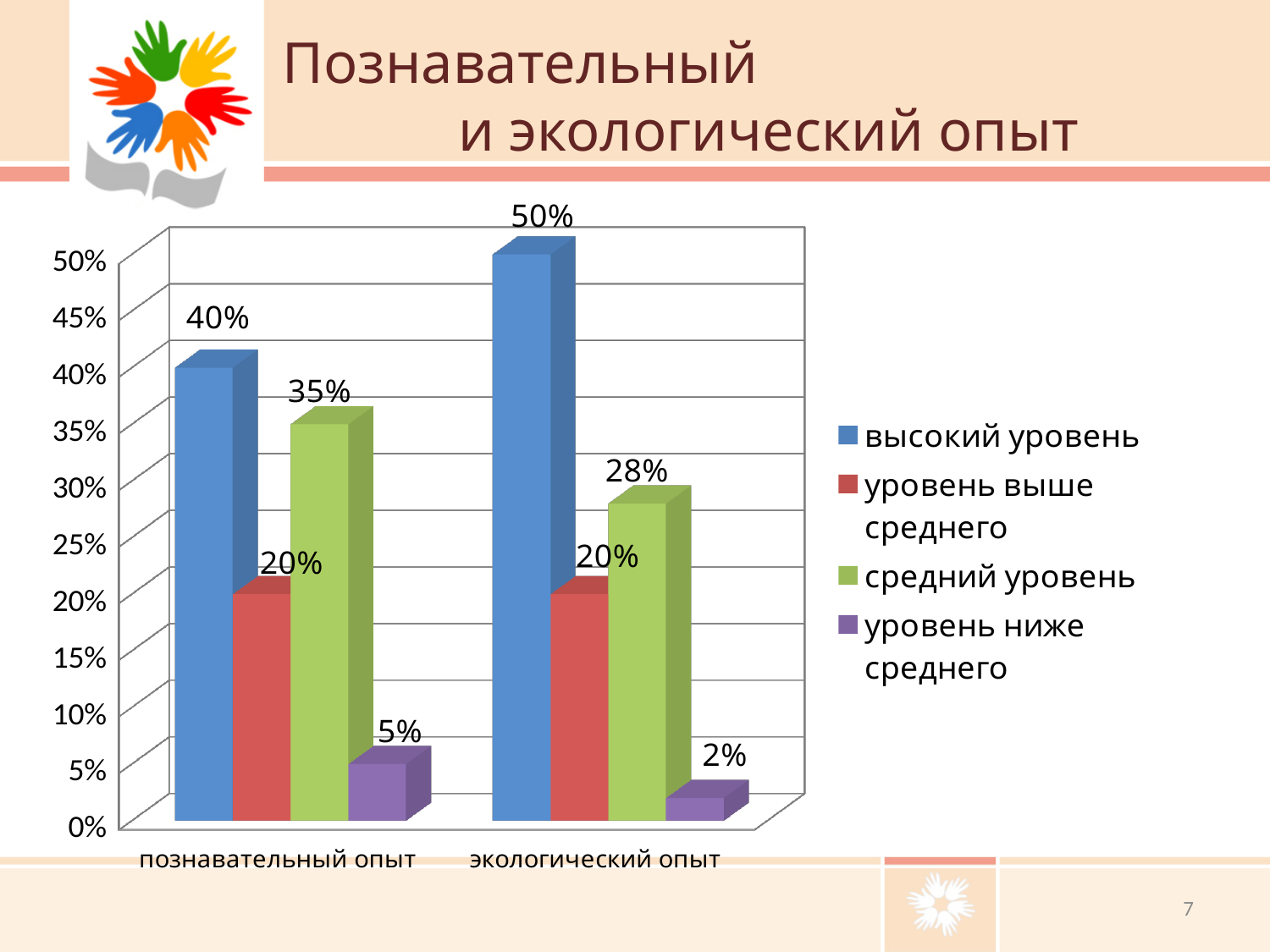
What colour represents средний уровень in the chart? green What is the value for высокий уровень in the познавательный опыт category? 40% How many categories are shown on the x axis? 2 What is the value for уровень выше среднего in the познавательный опыт category? 20% Which series has the highest value in the экологический опыт category? высокий уровень Which is larger: средний уровень for познавательный опыт or средний уровень for экологический опыт? познавательный опыт What is the difference between the высокий уровень values for экологический опыт and познавательный опыт? 10% Which series has the lowest value in the познавательный опыт category? уровень ниже среднего What is the value for уровень ниже среднего in the экологический опыт category? 2% What kind of chart is shown on the slide? bar chart What is the value for средний уровень in the экологический опыт category? 28% How many series does the legend list? 4